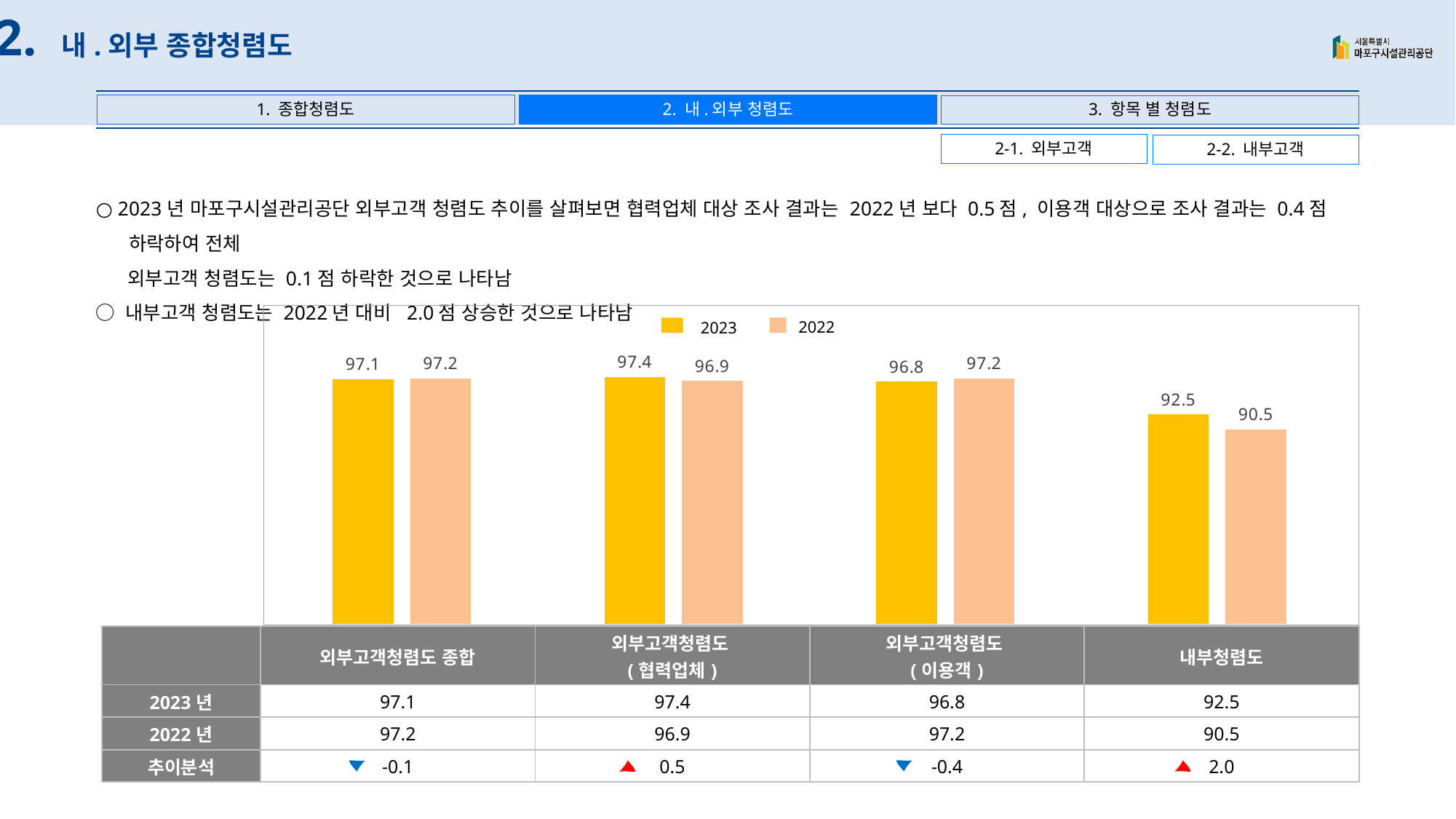
How many categories are shown in the chart? 4 How many series does the chart legend list? 2 What is the difference between the 2023 and 2022 values for 내부청렴도? 2.0 What is the difference between the 2022 and 2023 values for 외부고객청렴도 (이용객)? 0.4 What is the 2022 value for 외부고객청렴도 (협력업체) in the chart? 96.9 For 외부고객청렴도 (협력업체), which year has the larger value, 2023 or 2022? 2023 What type of chart is shown on the slide? bar chart Which category has the lowest 2022 value in the chart? 내부청렴도 Which category has the highest 2023 value in the chart? 외부고객청렴도 (협력업체) What is the 2023 value for 내부청렴도 in the chart? 92.5 What is the 2023 value for 외부고객청렴도 (이용객) in the chart? 96.8 For 내부청렴도, is the 2022 value larger or smaller than the 2023 value? smaller